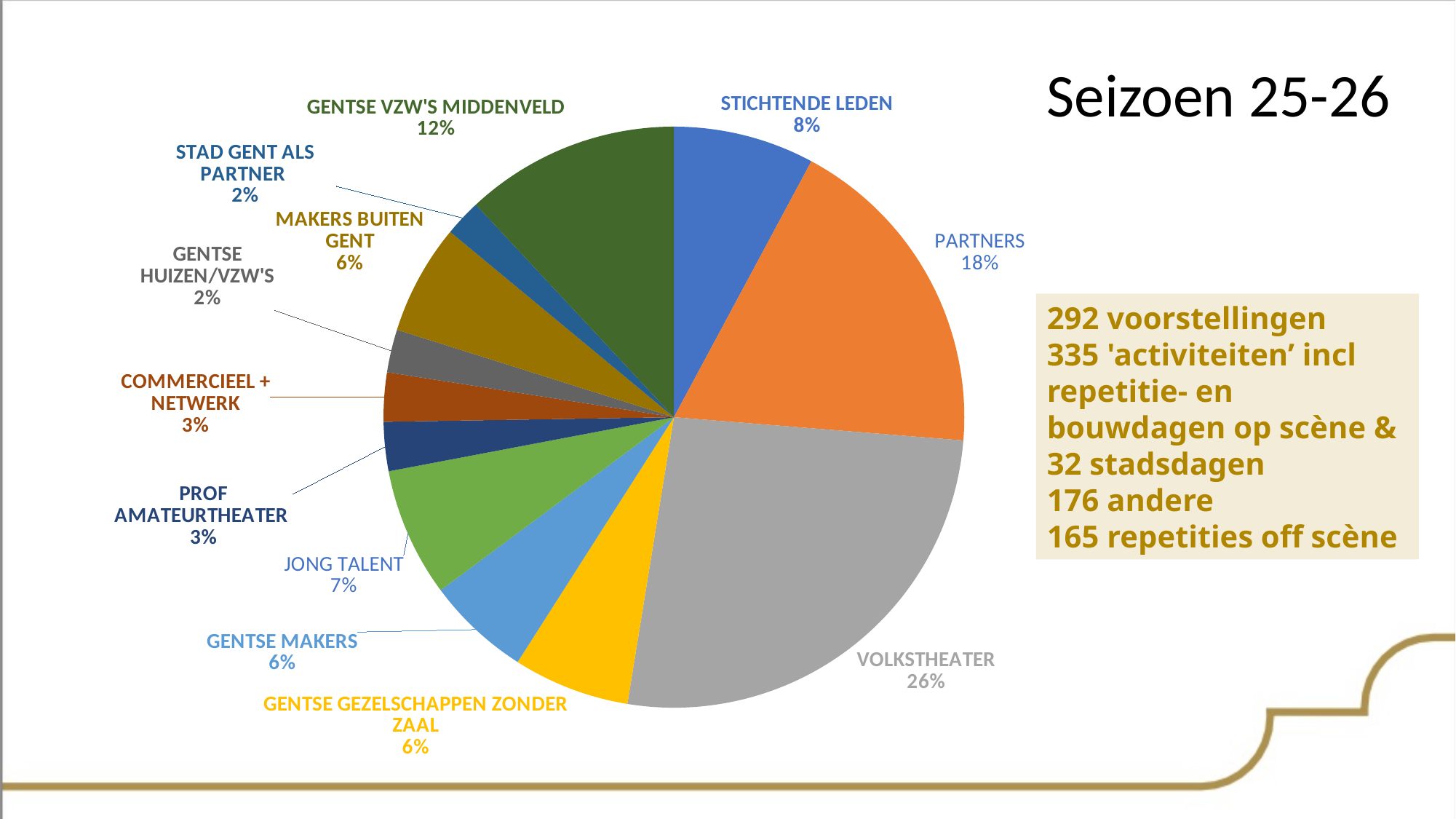
What is the combined percentage of PROF AMATEURTHEATER and COMMERCIEEL + NETWERK? 6% What kind of chart is shown on the slide? pie chart What percentage is shown for JONG TALENT? 7% Which is larger, the share for GENTSE VZW'S MIDDENVELD or the share for STICHTENDE LEDEN? GENTSE VZW'S MIDDENVELD What percentage is shown for GENTSE VZW'S MIDDENVELD? 12% What percentage is shown for PARTNERS? 18% What is the title shown at the top right of the slide? Seizoen 25-26 What is the difference in percentage points between VOLKSTHEATER and PARTNERS? 8 How many slices does the pie chart have? 12 What percentage is shown for STICHTENDE LEDEN? 8% What share of the pie does VOLKSTHEATER represent? 26% Which category has the largest slice of the pie? VOLKSTHEATER